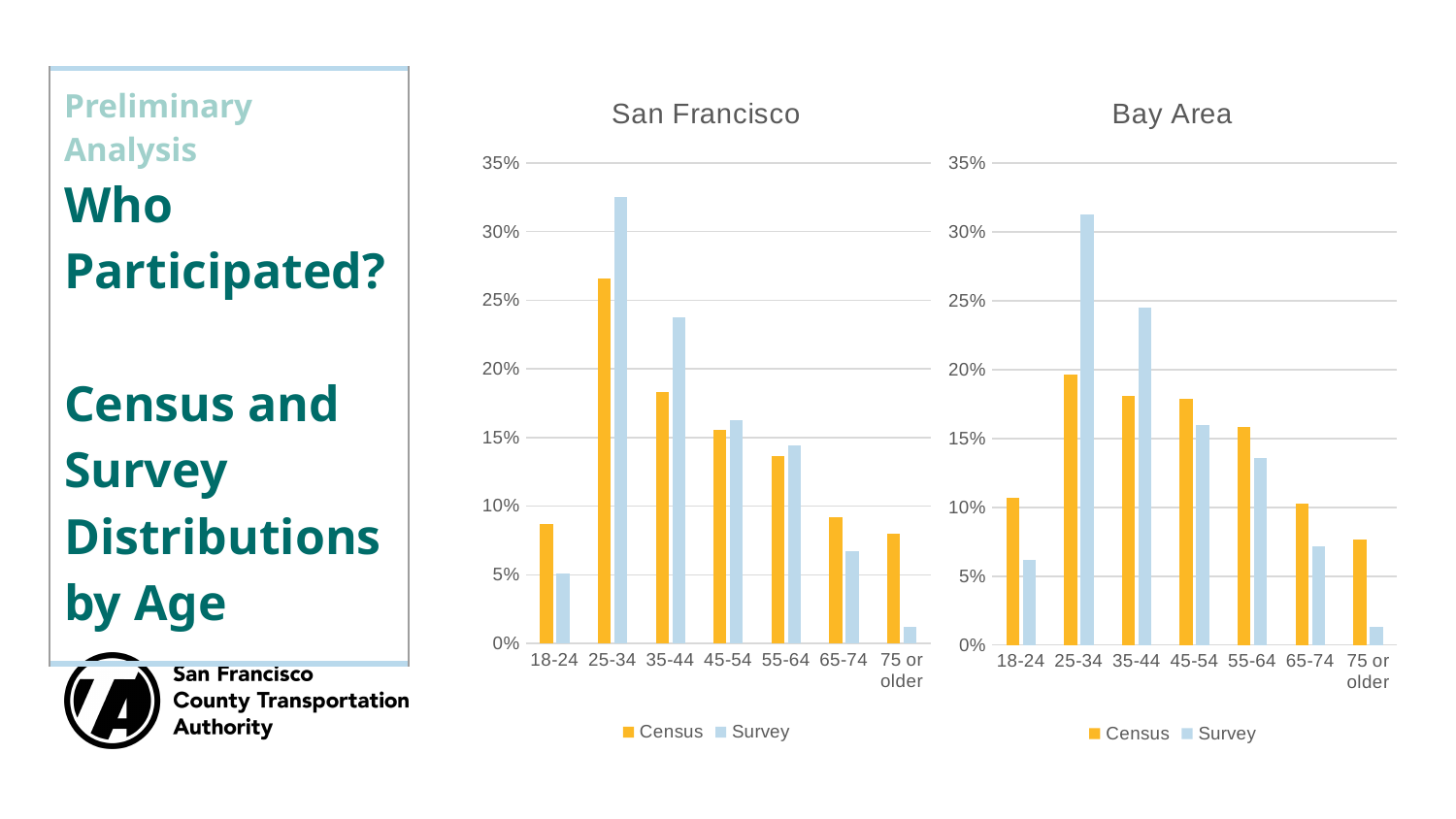
What kind of chart is the San Francisco chart? bar chart In the Bay Area chart, is the Survey value for 18-24 greater or less than 10%? less In the Bay Area chart, which is larger for the 18-24 age group, Census or Survey? Census In the San Francisco chart, which age group has the lowest Survey value? 75 or older In the San Francisco chart, which is larger for the 35-44 age group, Census or Survey? Survey In the San Francisco chart, do the Survey values rise or fall from 25-34 to 75 or older? fall In the Bay Area chart, which age group has the highest Survey value? 25-34 In the San Francisco chart, which age group has the highest Survey value? 25-34 How many series does the legend of the Bay Area chart list? 2 How many age groups are shown on the x axis of the Bay Area chart? 7 In the San Francisco chart, is the Census value for 25-34 greater or less than 25%? greater In the San Francisco chart, is the Survey value for 25-34 greater or less than 30%? greater